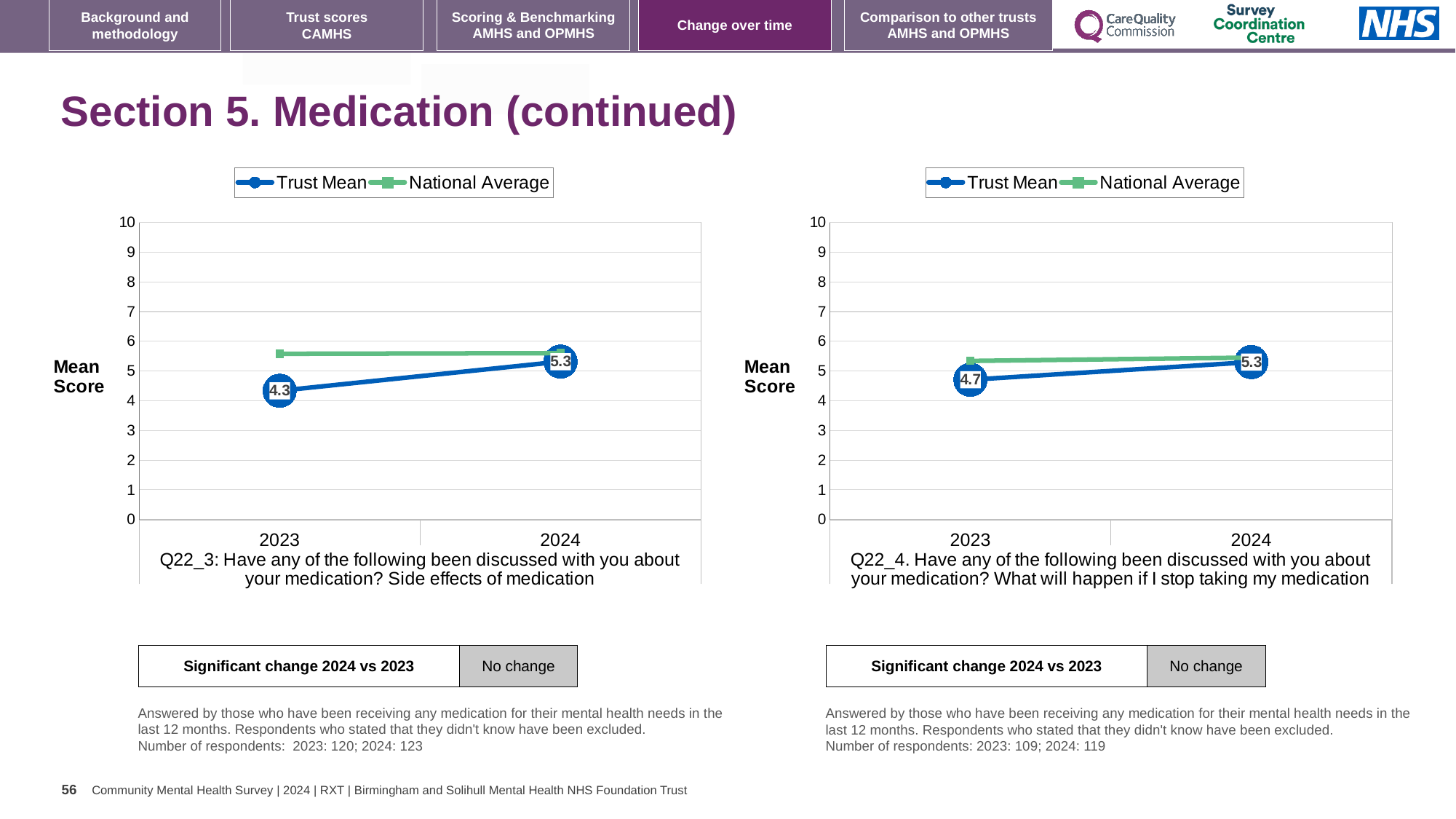
In the left chart (Q22_3), which is higher in 2023, the Trust Mean or the National Average? National Average In the right chart (Q22_4), which is higher in 2023, the Trust Mean or the National Average? National Average What type of chart is the left chart (Q22_3)? line chart In the left chart (Q22_3), by how much did the Trust Mean change from 2023 to 2024? 1.0 In the left chart (Q22_3), what is the Trust Mean for 2024? 5.3 In the left chart (Q22_3), does the Trust Mean rise or fall from 2023 to 2024? rise In the right chart (Q22_4), what is the Trust Mean for 2023? 4.7 In the right chart (Q22_4), by how much did the Trust Mean change from 2023 to 2024? 0.6 How many series does the legend of the right chart (Q22_4) list? 2 In the right chart (Q22_4), what is the Trust Mean for 2024? 5.3 In the left chart (Q22_3), what is the Trust Mean for 2023? 4.3 In the left chart (Q22_3), is the National Average for 2023 greater or less than 5? greater